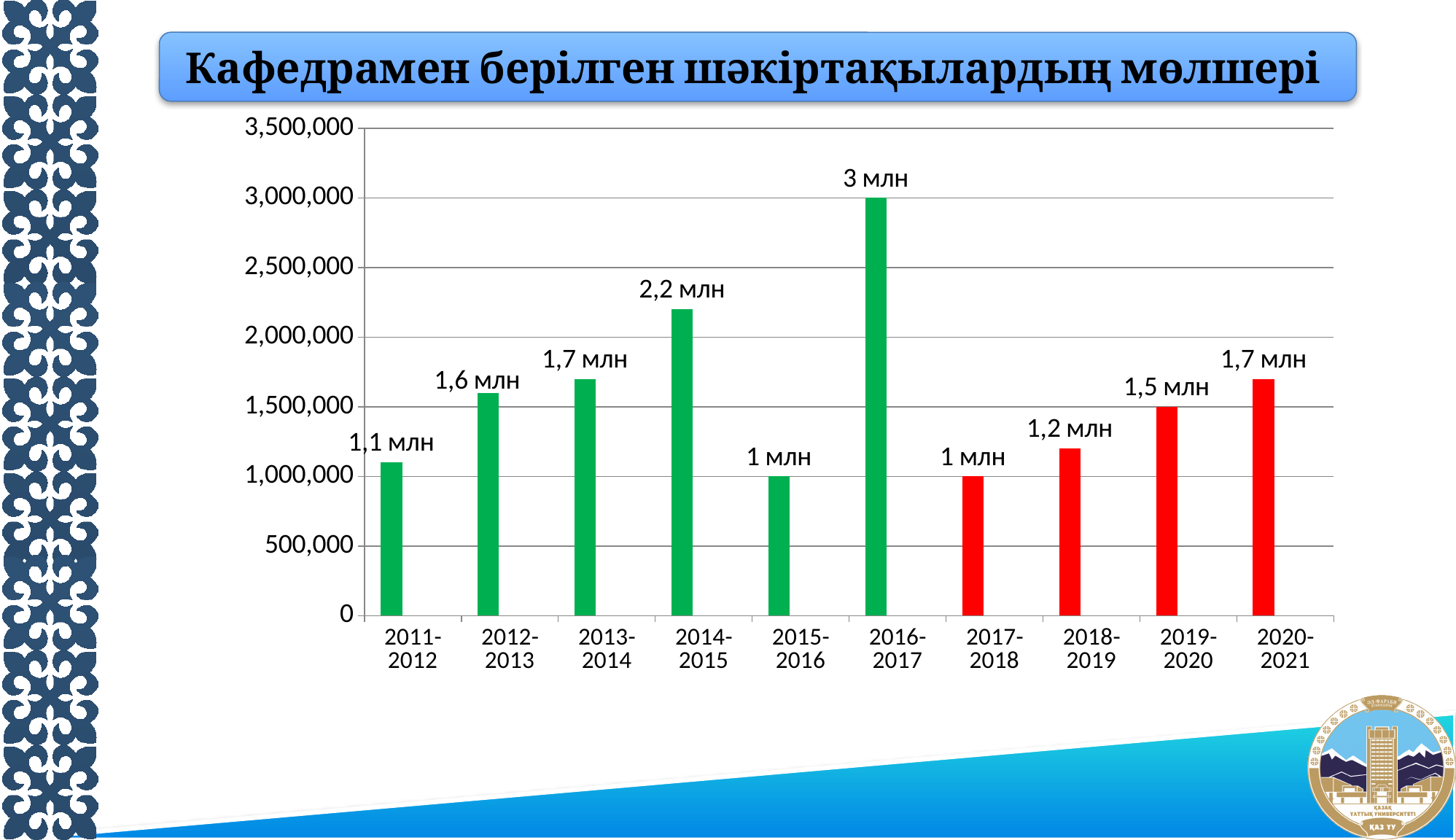
What is the value for 2014-2015? 2,2 млн Is the value for 2013-2014 greater or less than 1,500,000? greater Do the values rise or fall from 2017-2018 to 2020-2021? rise What kind of chart is shown on the slide? bar chart Which period has the highest value? 2016-2017 How many periods are shown on the x axis? 10 What is the value for 2018-2019? 1,2 млн What is the difference between the values for 2016-2017 and 2014-2015? 0,8 млн What colour are the bars for 2017-2018 through 2020-2021? red Which is larger, the value for 2019-2020 or the value for 2018-2019? 2019-2020 Which period has the lowest value, 2015-2016 or 2016-2017? 2015-2016 What is the value for 2016-2017? 3 млн